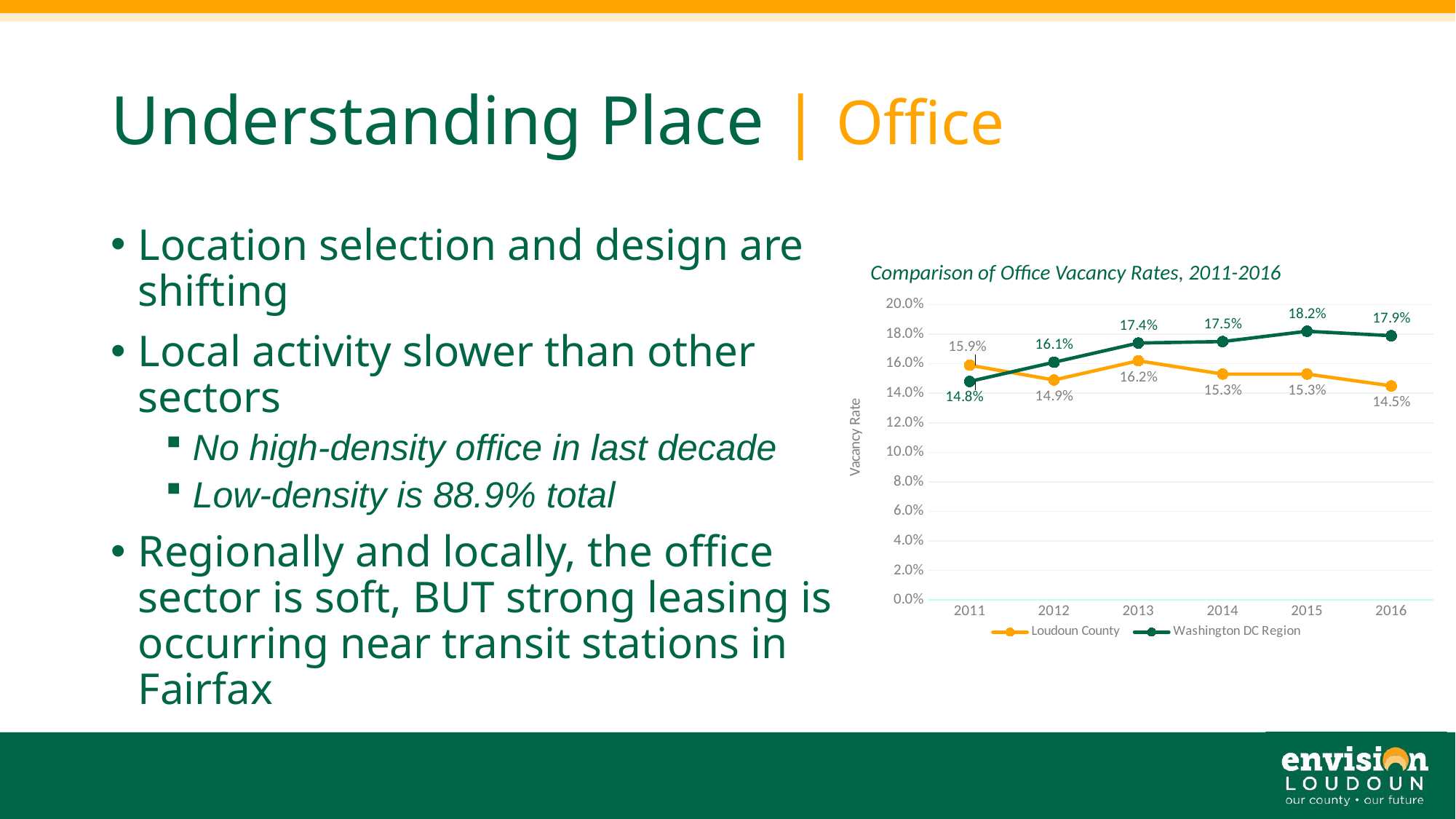
Did the Loudoun County vacancy rate rise or fall from 2013 to 2016? Fall How many series does the chart's legend list? 2 How many years are shown on the x axis of the chart? 6 In which year was the Washington DC Region vacancy rate highest? 2015 What kind of chart is shown on the slide? Line chart What was the office vacancy rate for the Washington DC Region in 2015? 18.2% What was the office vacancy rate for Loudoun County in 2016? 14.5% In which year was the Loudoun County vacancy rate lowest? 2016 Which had the higher vacancy rate in 2011, Loudoun County or the Washington DC Region? Loudoun County What is the difference between the Washington DC Region and Loudoun County vacancy rates in 2016? 3.4% What was the office vacancy rate for Loudoun County in 2013? 16.2% What is the title of the chart? Comparison of Office Vacancy Rates, 2011-2016